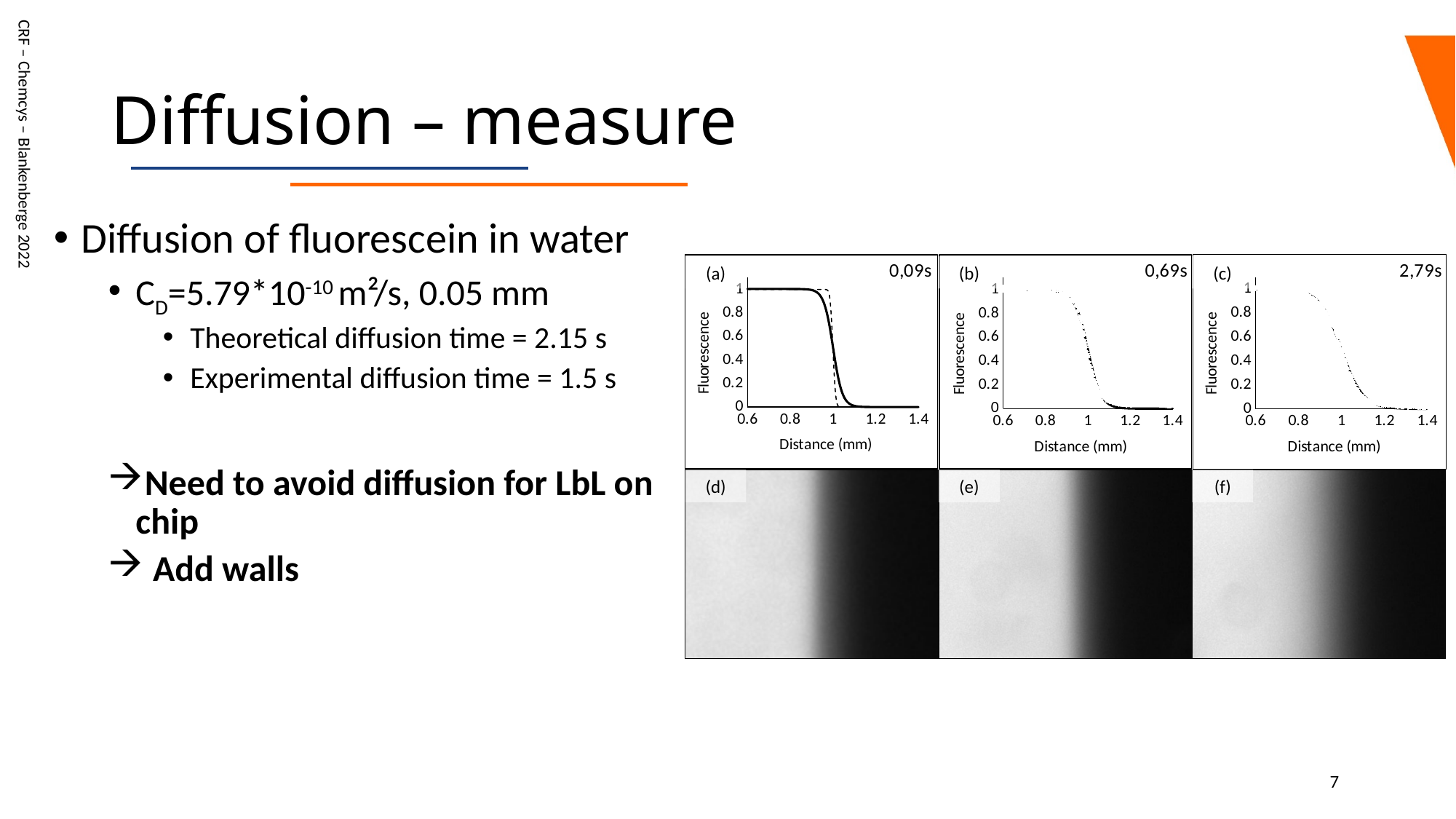
What is the x-axis label of chart (b)? Distance (mm) What kind of chart is chart (a)? line chart What is the y-axis label of chart (c)? Fluorescence In chart (b), is the fluorescence at a distance of 1.2 mm greater or less than 0.4? less In chart (c), does fluorescence rise or fall as distance increases? fall In chart (c), is the fluorescence at a distance of 0.8 mm greater or less than 0.6? greater In chart (a), which is larger: the fluorescence at 0.8 mm or at 1.2 mm? 0.8 mm In chart (a), does fluorescence rise or fall as distance increases along the x axis? fall How many fluorescence-versus-distance charts are shown on the slide? 3 In chart (c), is the fluorescence at a distance of 1.2 mm greater or less than 0.2? less